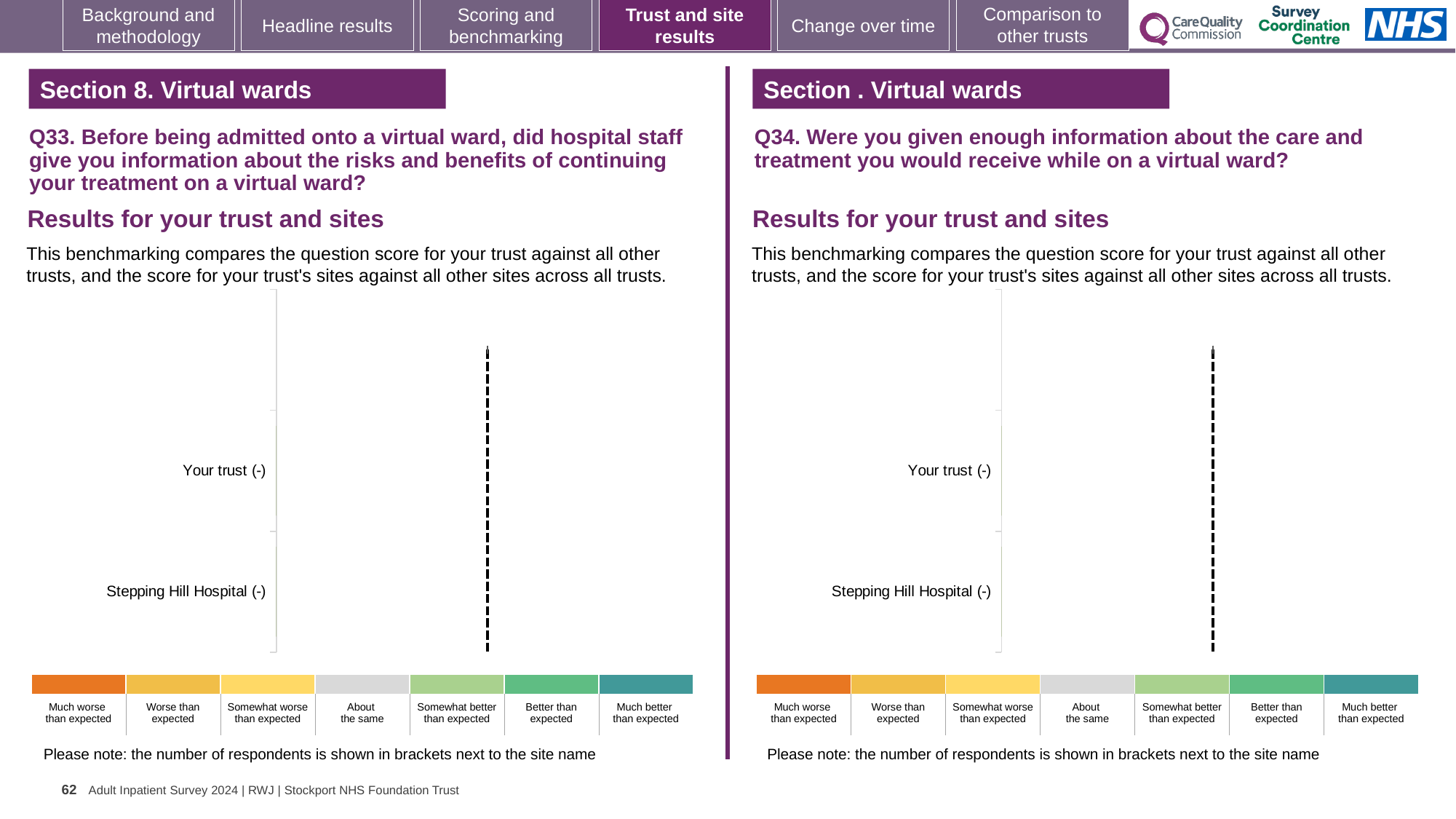
In the Q34 chart on the right, what is the label of the leftmost (orange) band in the key beneath the chart? Much worse than expected In the Q34 chart on the right, what is shown in brackets next to Your trust as the number of respondents? - In the Q34 chart on the right, how many categories are listed on the vertical axis? 2 In the Q33 chart on the left, what is shown in brackets next to Stepping Hill Hospital as the number of respondents? - In the Q33 chart on the left, how many categories are listed on the vertical axis? 2 In the Q33 chart on the left, how many colour bands are shown in the key beneath the chart? 7